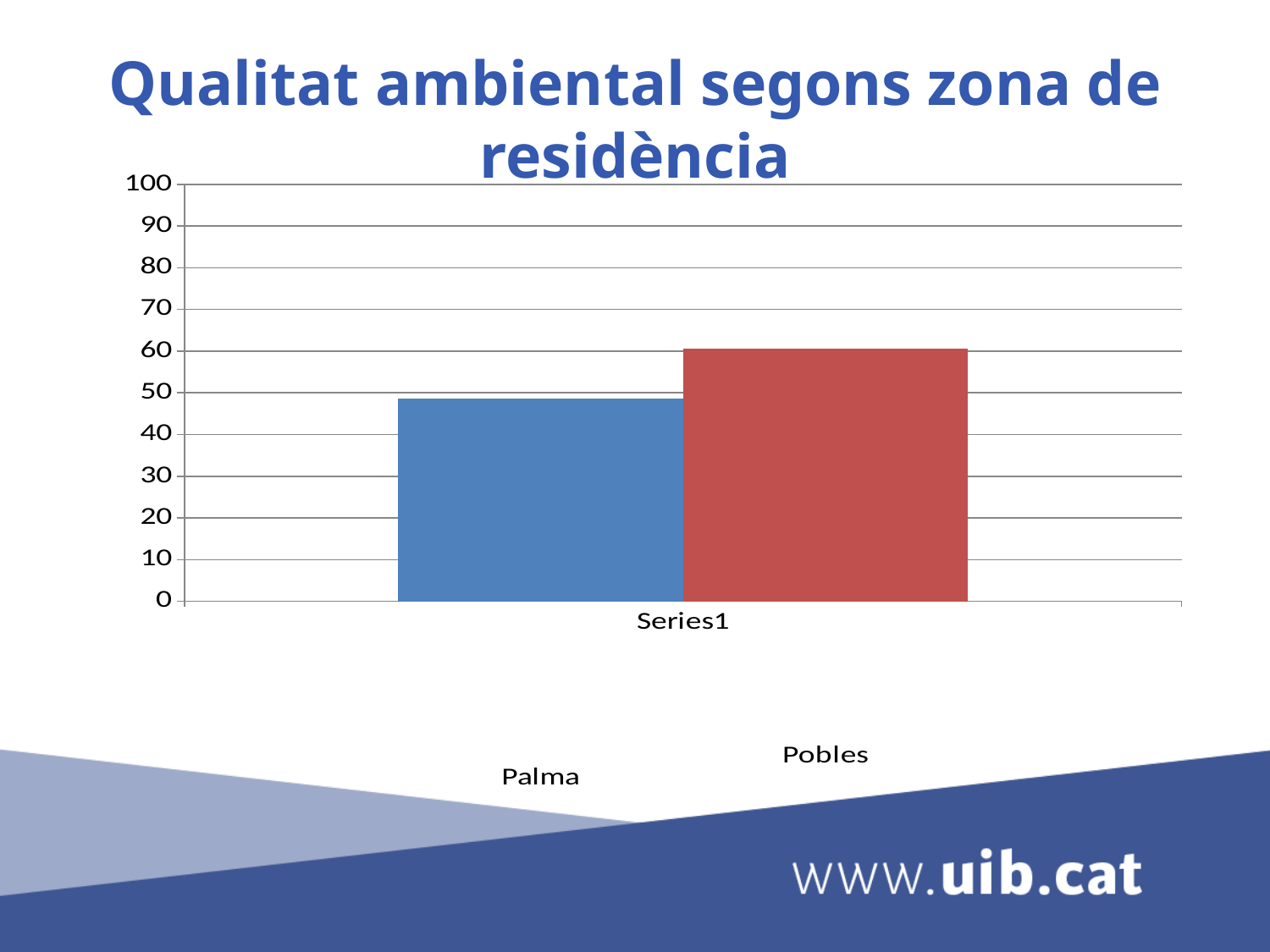
Is the value for Pobles greater or less than 70? less Which series has the lowest value? Palma What kind of chart is shown on the slide? bar chart Is the value for Palma greater or less than 40? greater Is the value for Pobles greater or less than 50? greater What colour is the bar for Pobles? red What is the category label shown on the x axis? Series1 What is the title of the chart? Qualitat ambiental segons zona de residència How many series does the legend list? 2 Which is larger, the value for Palma or the value for Pobles? Pobles Which series has the highest value? Pobles